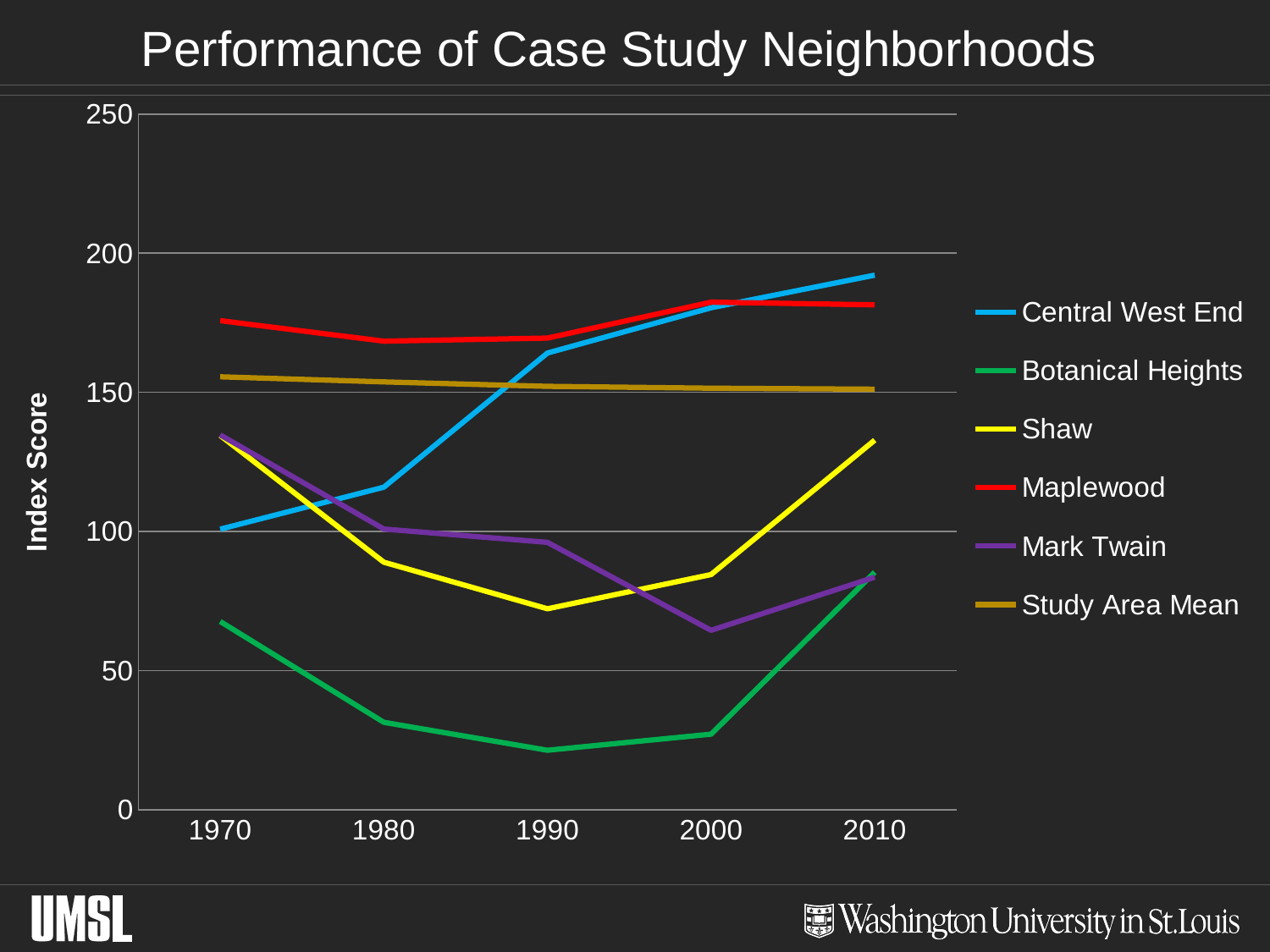
What kind of chart is shown on the slide? line chart Which series has the lowest index score in 1990? Botanical Heights Is the value for Botanical Heights in 1990 greater or less than 50? less Does the Central West End line rise or fall from 1970 to 2010? rise Is the value for Mark Twain in 2000 greater or less than 100? less What is the label on the y axis? Index Score Is the value for Central West End in 2010 greater or less than 150? greater How many series does the legend list? 6 Which neighborhood has the highest index score in 1970? Maplewood In 2010, which is larger: the value for Central West End or the value for Maplewood? Central West End How many years are plotted along the x axis? 5 Which series has the highest index score in 2010? Central West End